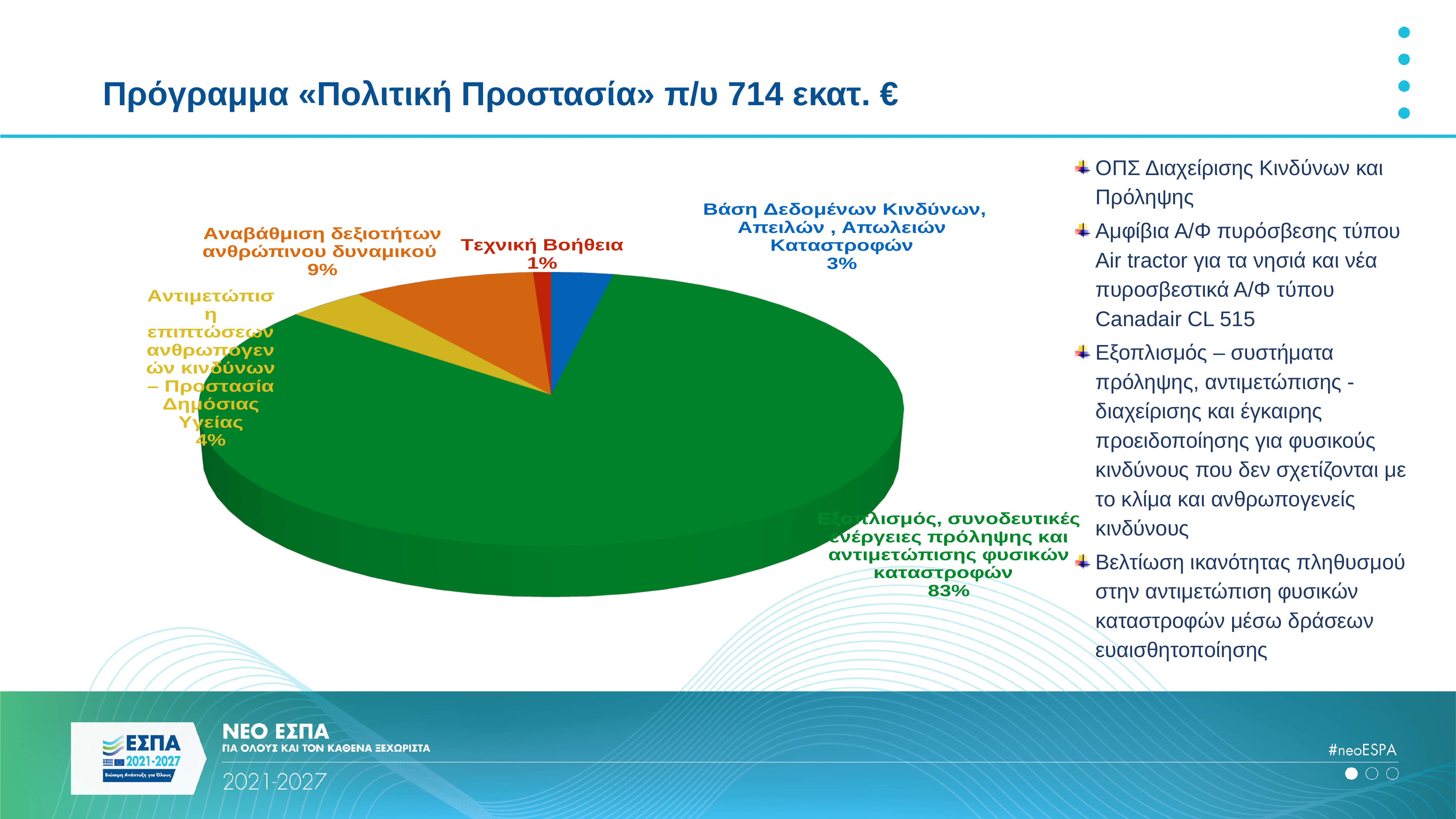
What percentage is shown for "Τεχνική Βοήθεια"? 1% Which slice of the pie chart is the largest? Εξοπλισμός, συνοδευτικές ενέργειες πρόληψης και αντιμετώπισης φυσικών καταστροφών What colour is the slice for "Τεχνική Βοήθεια"? Red Which is larger: the share for "Αντιμετώπιση επιπτώσεων ανθρωπογενών κινδύνων – Προστασία Δημόσιας Υγείας" or for "Βάση Δεδομένων Κινδύνων, Απειλών, Απωλειών Καταστροφών"? Αντιμετώπιση επιπτώσεων ανθρωπογενών κινδύνων – Προστασία Δημόσιας Υγείας How many slices does the pie chart have? 5 What percentage is shown for "Αντιμετώπιση επιπτώσεων ανθρωπογενών κινδύνων – Προστασία Δημόσιας Υγείας"? 4% What share of the pie does "Εξοπλισμός, συνοδευτικές ενέργειες πρόληψης και αντιμετώπισης φυσικών καταστροφών" represent? 83% What percentage is shown for "Αναβάθμιση δεξιοτήτων ανθρώπινου δυναμικού"? 9% What is the difference in percentage points between "Αναβάθμιση δεξιοτήτων ανθρώπινου δυναμικού" and "Βάση Δεδομένων Κινδύνων, Απειλών, Απωλειών Καταστροφών"? 6 percentage points What percentage is shown for "Βάση Δεδομένων Κινδύνων, Απειλών, Απωλειών Καταστροφών"? 3% What kind of chart is shown on the slide? Pie chart Which slice of the pie chart is the smallest? Τεχνική Βοήθεια